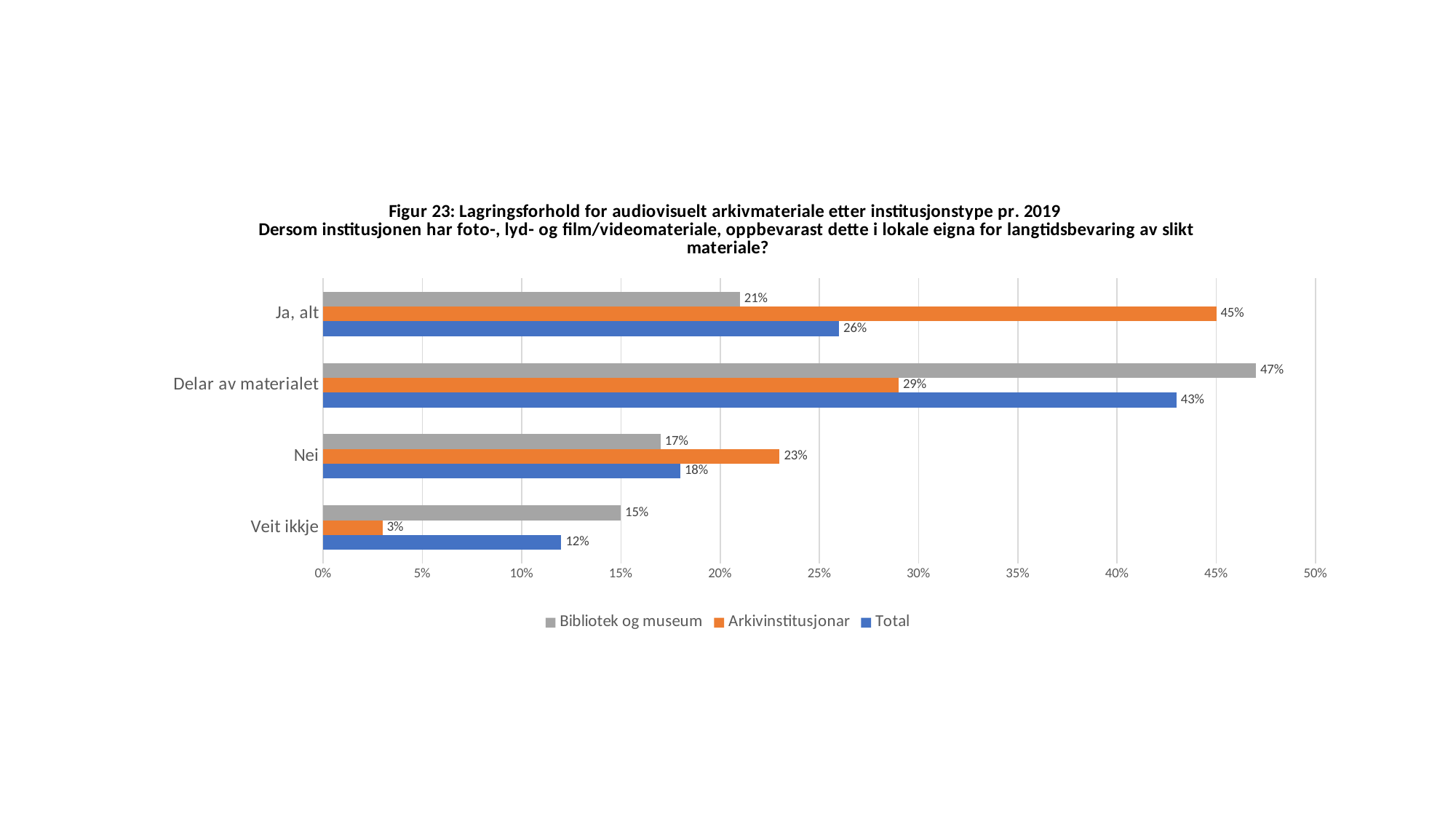
Which series is shown in orange in the legend? Arkivinstitusjonar What is the difference between the Arkivinstitusjonar and Bibliotek og museum values for 'Ja, alt'? 24% What kind of chart is shown on the slide? Bar chart Which category has the highest value for Bibliotek og museum? Delar av materialet What is the value for Bibliotek og museum in the 'Veit ikkje' category? 15% Which is larger for 'Nei': the Arkivinstitusjonar value or the Total value? Arkivinstitusjonar What is the value for Arkivinstitusjonar in the 'Ja, alt' category? 45% What is the Total value for 'Delar av materialet'? 43% How many series does the legend list? 3 What is the difference between the Total values for 'Delar av materialet' and 'Ja, alt'? 17% Which category has the lowest value for Arkivinstitusjonar? Veit ikkje How many response categories are shown on the chart? 4